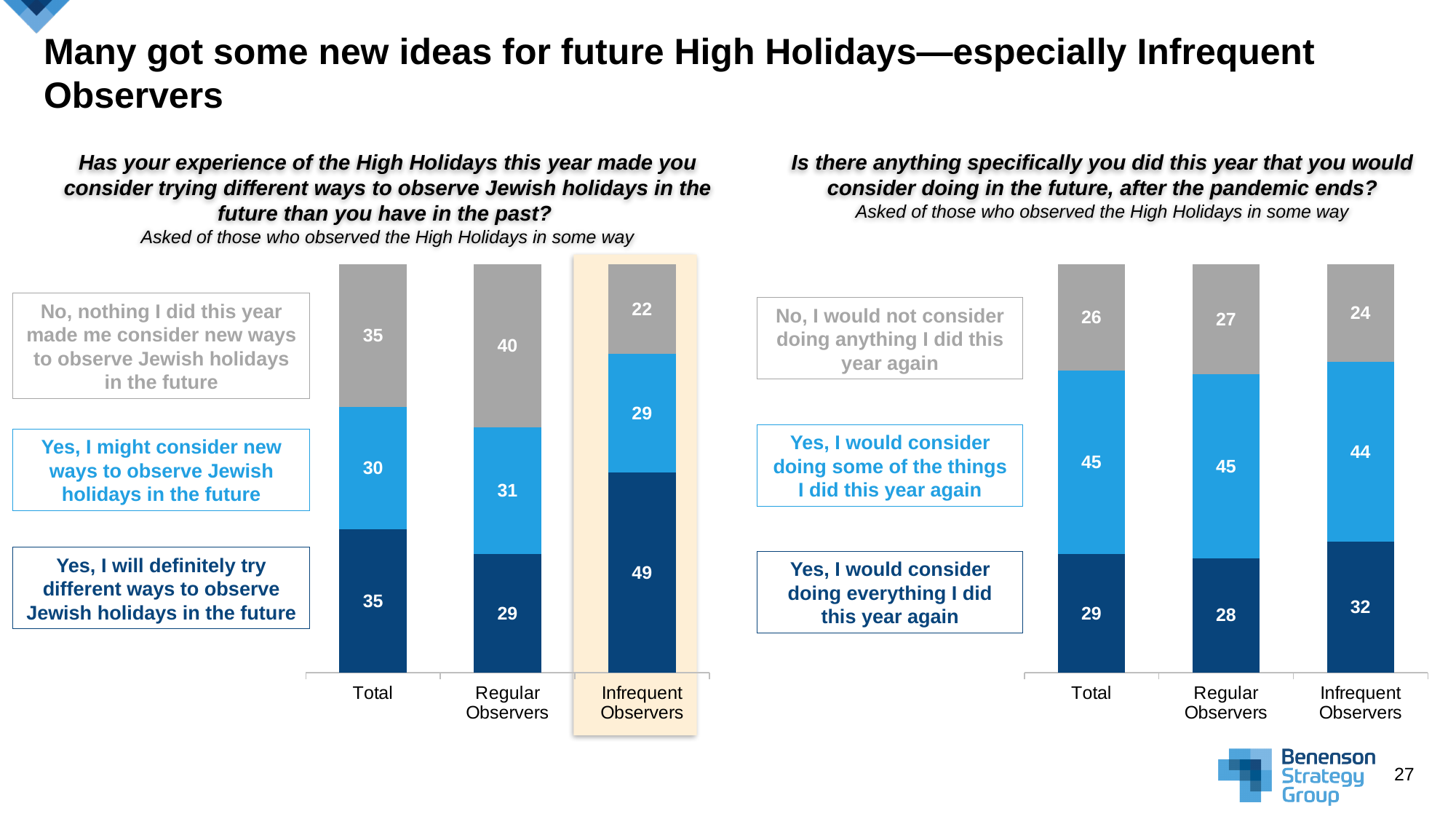
In the right chart, which group has the lowest value for 'No, I would not consider doing anything I did this year again'? Infrequent Observers In the left chart, what is the difference between the 'Yes, I will definitely try' values for Infrequent Observers and Regular Observers? 20 In the right chart, what is the value for Infrequent Observers who said 'Yes, I would consider doing everything I did this year again'? 32 In the right chart, what is the value for Total who said 'Yes, I would consider doing some of the things I did this year again'? 45 In the left chart, what is the value for Regular Observers who said 'No, nothing I did this year made me consider new ways to observe Jewish holidays in the future'? 40 In the left chart, which group has the highest value for 'Yes, I will definitely try different ways to observe Jewish holidays in the future'? Infrequent Observers In the left chart, which group's bar is highlighted with a shaded background? Infrequent Observers In the left chart, what is the value for Infrequent Observers who said 'Yes, I will definitely try different ways to observe Jewish holidays in the future'? 49 In the right chart, which is larger: the 'Yes, I would consider doing everything' value for Infrequent Observers or for Regular Observers? Infrequent Observers How many response categories are stacked in each bar of the left chart? 3 What kind of chart is the left chart? Stacked bar chart How many groups are shown on the x axis of the right chart? 3